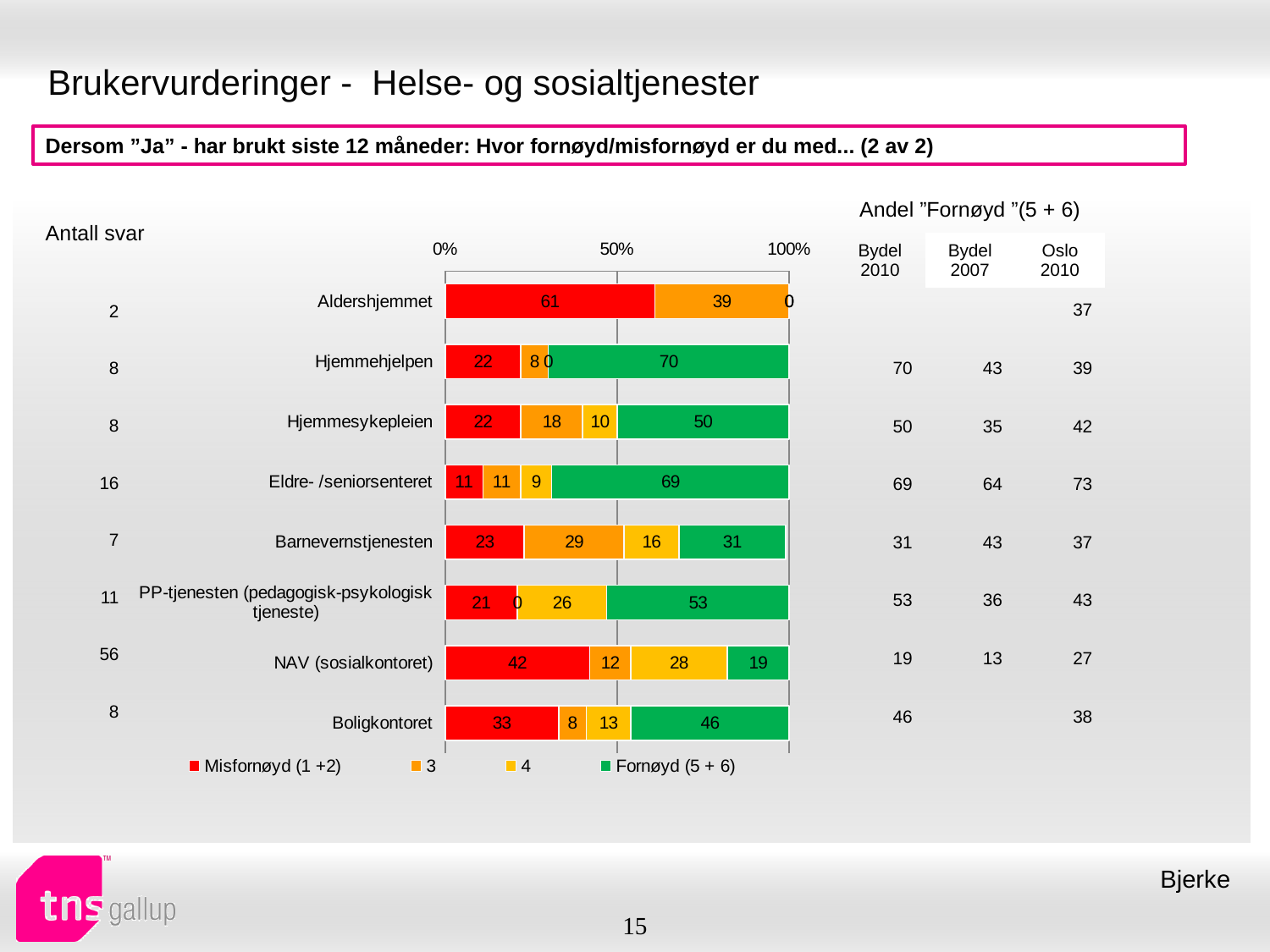
What kind of chart is shown on the slide? Stacked bar chart What is the difference between the Fornøyd (5 + 6) values for Hjemmehjelpen and Hjemmesykepleien? 20 What is the value of the '4' segment for NAV (sosialkontoret)? 28 What colour represents Fornøyd (5 + 6) in the chart? Green Which category has the lowest Misfornøyd (1 +2) value? Eldre- /seniorsenteret What is the value of the Misfornøyd (1 +2) segment for NAV (sosialkontoret)? 42 How many series does the legend list? 4 How many categories are shown in the chart? 8 Which has the larger Misfornøyd (1 +2) value, Boligkontoret or Barnevernstjenesten? Boligkontoret What is the value of the '3' segment for Barnevernstjenesten? 29 Which category has the highest Misfornøyd (1 +2) value? Aldershjemmet What is the value of the Fornøyd (5 + 6) segment for Hjemmehjelpen? 70